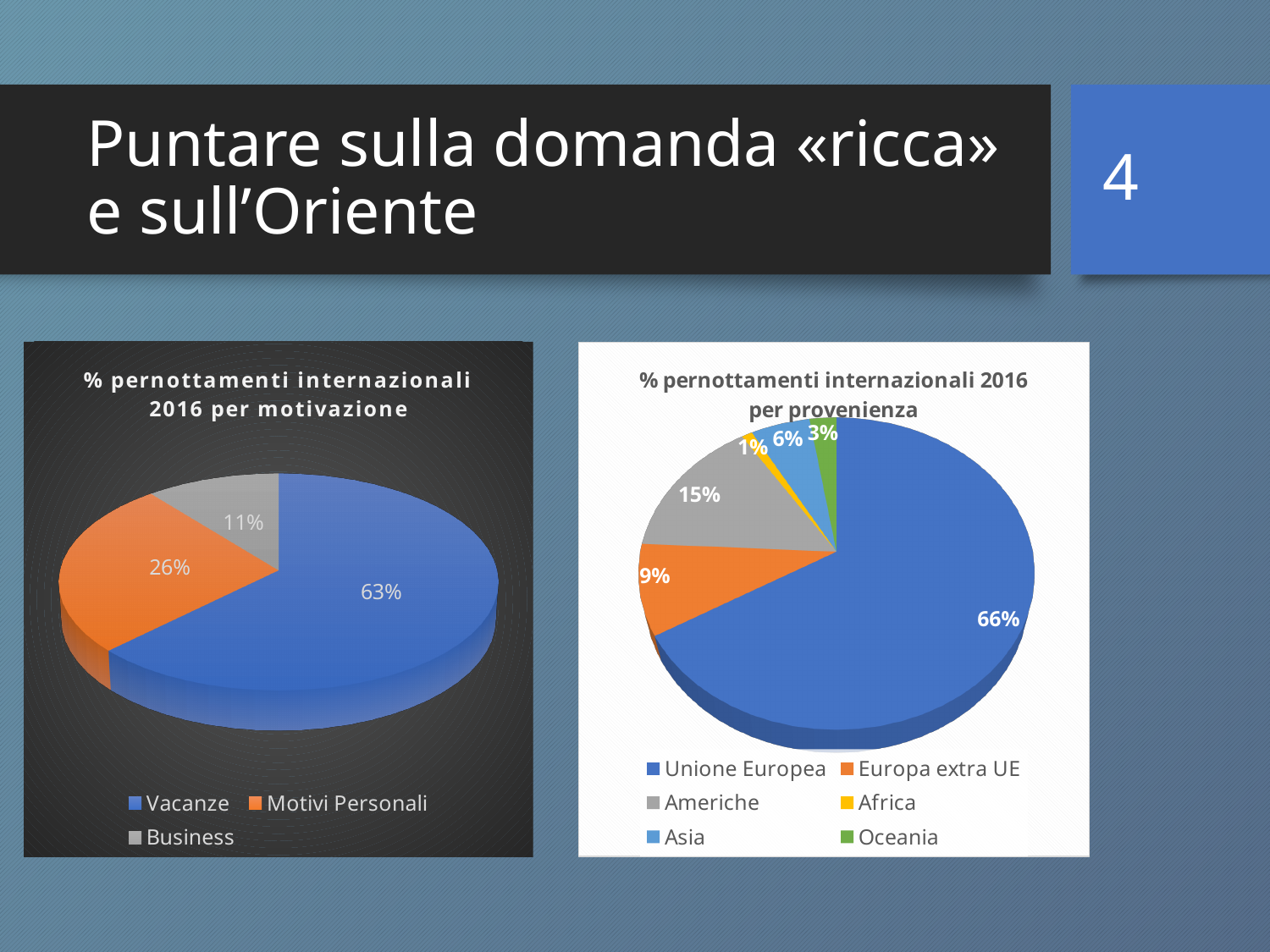
In the chart titled '% pernottamenti internazionali 2016 per provenienza', what share is labelled for Unione Europea? 66% In the chart titled '% pernottamenti internazionali 2016 per motivazione', what share is labelled for Business? 11% In the chart titled '% pernottamenti internazionali 2016 per motivazione', which category has the largest slice? Vacanze In the chart titled '% pernottamenti internazionali 2016 per motivazione', how many categories does the legend list? 3 In the chart titled '% pernottamenti internazionali 2016 per motivazione', what is the difference between the Motivi Personali and Business shares? 15% In the chart titled '% pernottamenti internazionali 2016 per provenienza', what share is labelled for Americhe? 15% In the chart titled '% pernottamenti internazionali 2016 per provenienza', which category has the smallest slice? Africa In the chart titled '% pernottamenti internazionali 2016 per motivazione', what share is labelled for Vacanze? 63% In the chart titled '% pernottamenti internazionali 2016 per provenienza', what colour is the Oceania slice? Green In the chart titled '% pernottamenti internazionali 2016 per provenienza', how many categories does the legend list? 6 In the chart titled '% pernottamenti internazionali 2016 per provenienza', which is larger, the Asia share or the Europa extra UE share? Europa extra UE What type of chart is the one on the right of the slide? Pie chart